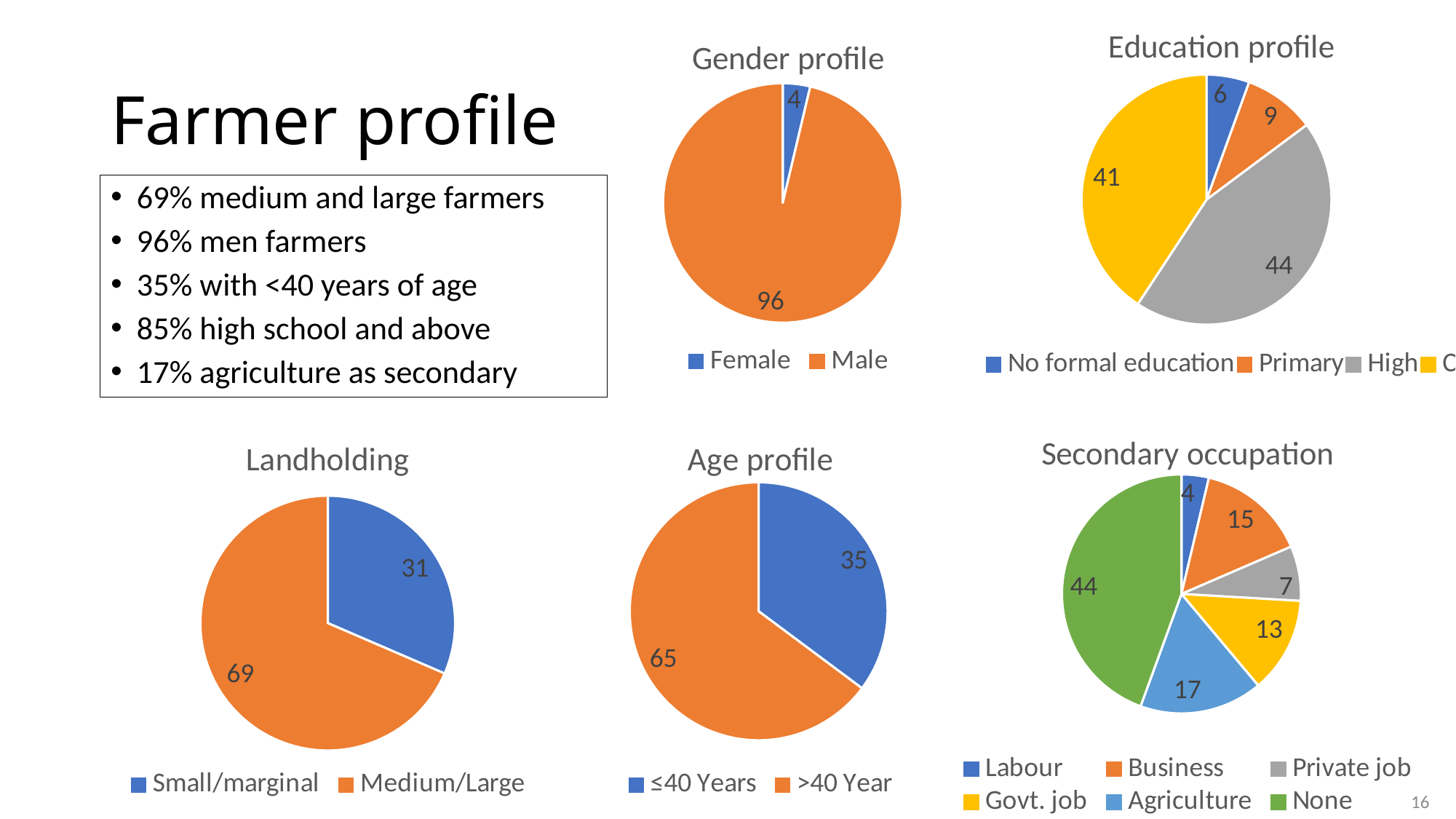
In the Landholding chart, what is the difference between Medium/Large and Small/marginal? 38 In the Education profile chart, which category has the lowest value? No formal education In the Age profile chart, which is larger, ≤40 Years or >40 Year? >40 Year How many categories does the legend of the Secondary occupation chart list? 6 In the Education profile chart, which category has the highest value? High In the Secondary occupation chart, which category has the lowest value? Labour In the Secondary occupation chart, what is the value for Agriculture? 17 What type of chart is the Landholding chart? Pie chart In the Education profile chart, what is the value for Primary? 9 In the Secondary occupation chart, which category has the highest value? None In the Gender profile chart, what is the value for Female? 4 In the Gender profile chart, what is the value for Male? 96